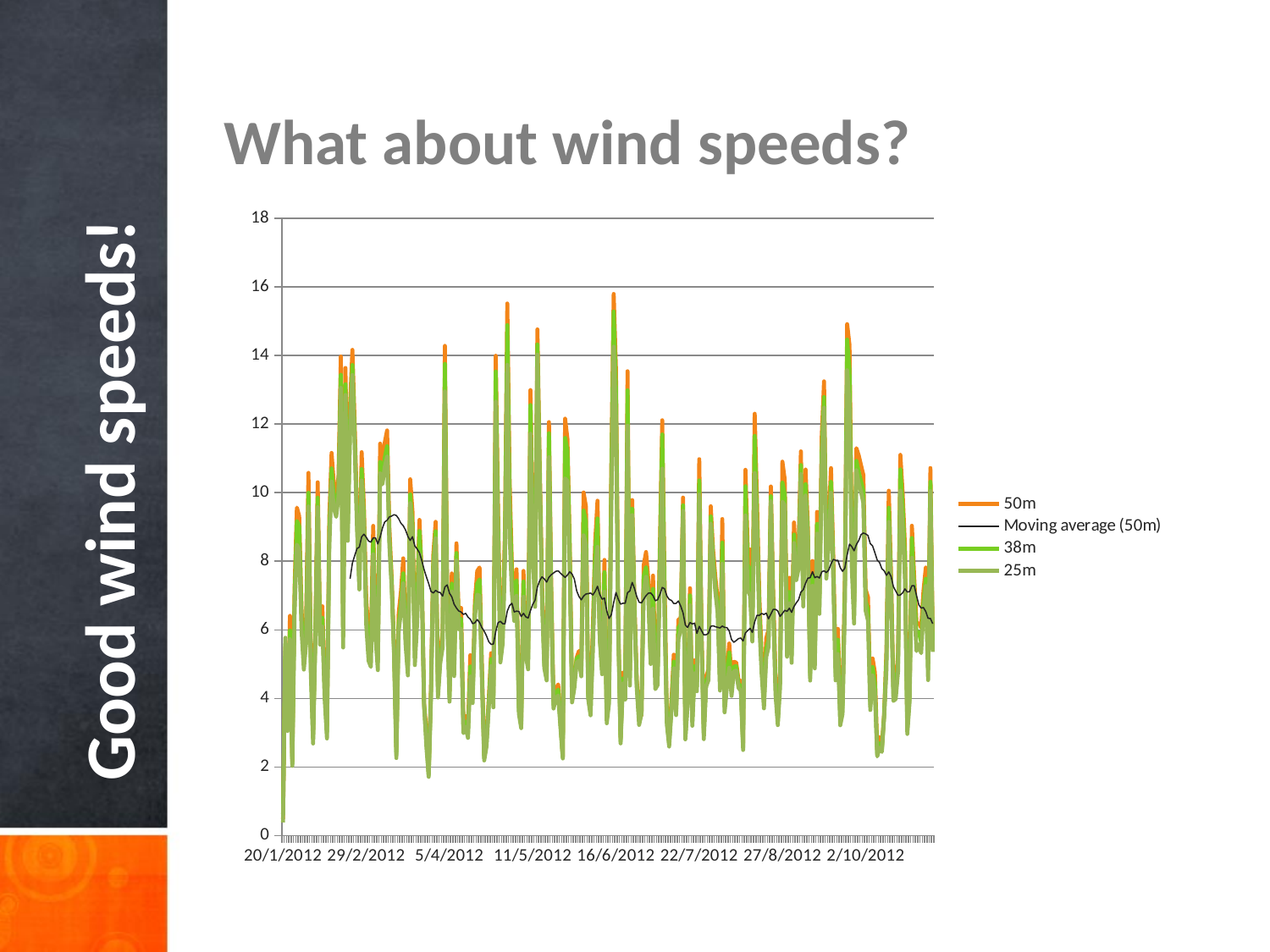
What kind of chart is shown on the slide? line chart What is the first date label on the horizontal axis? 20/1/2012 Is the highest peak of the 50m series greater or less than 14? greater What is the last date label on the horizontal axis? 2/10/2012 What is the title of the slide above the chart? What about wind speeds? Is the highest point of the Moving average (50m) line greater or less than 10? less What is the highest value shown on the vertical axis? 18 How many series does the legend list? 4 Is the lowest point of the Moving average (50m) line greater or less than 4? greater How many date labels are printed along the horizontal axis? 8 Which series is drawn as a thin black line? Moving average (50m)